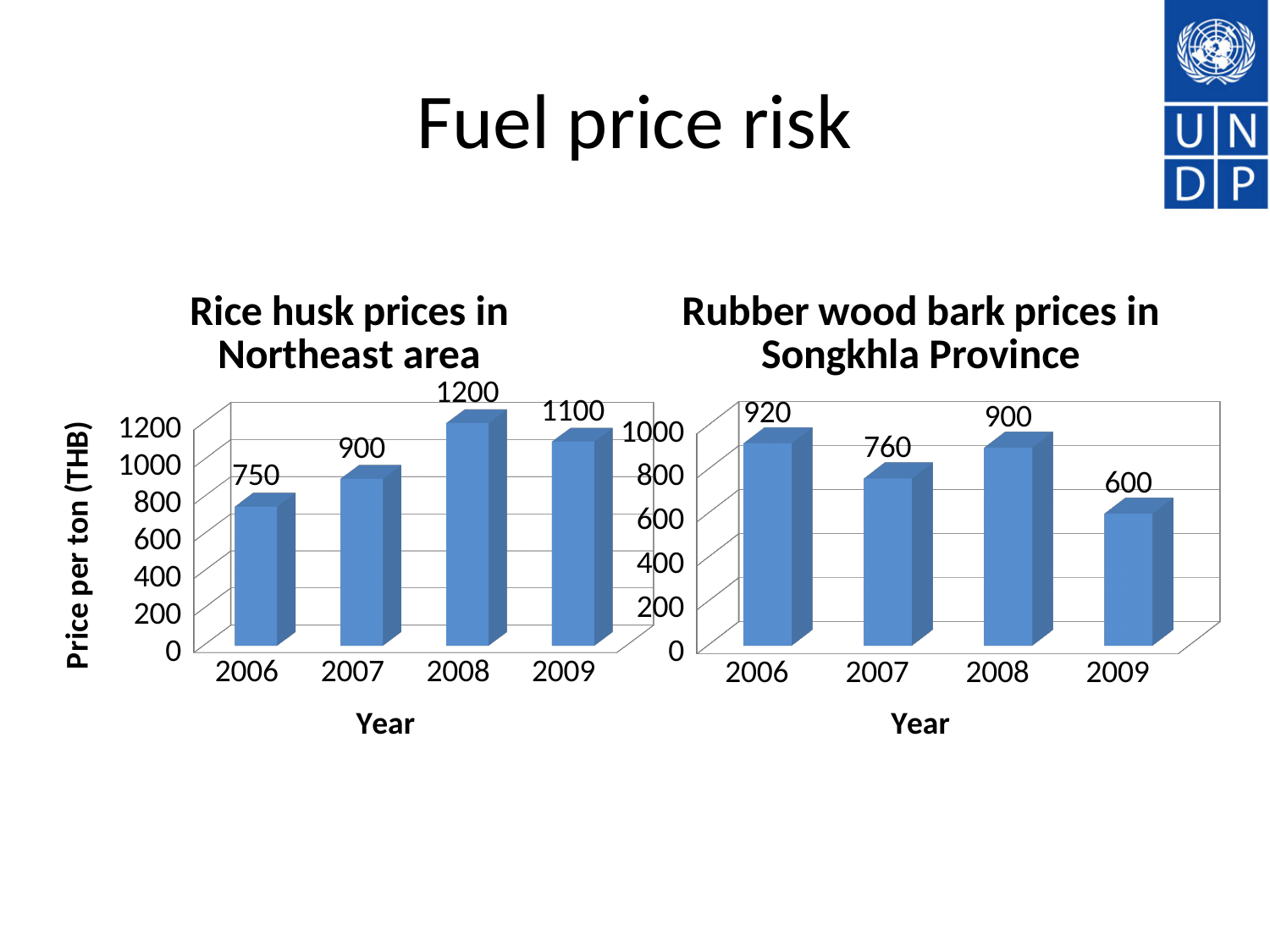
How many years are shown on the x axis of the 'Rice husk prices in Northeast area' chart? 4 In the 'Rubber wood bark prices in Songkhla Province' chart, is the value for 2009 greater or less than 800? less In the 'Rice husk prices in Northeast area' chart, which year has the lowest price? 2006 What kind of chart is the 'Rubber wood bark prices in Songkhla Province' chart? bar chart In the 'Rubber wood bark prices in Songkhla Province' chart, what is the price per ton in 2007? 760 In the 'Rice husk prices in Northeast area' chart, what is the price per ton in 2008? 1200 What is the y-axis label of the 'Rice husk prices in Northeast area' chart? Price per ton (THB) In the 'Rubber wood bark prices in Songkhla Province' chart, which year has the highest price? 2006 In the 'Rice husk prices in Northeast area' chart, which is larger, the 2007 price or the 2009 price? 2009 In the 'Rice husk prices in Northeast area' chart, what is the difference between the 2008 and 2006 prices? 450 In the 'Rubber wood bark prices in Songkhla Province' chart, do prices rise or fall from 2008 to 2009? fall In the 'Rubber wood bark prices in Songkhla Province' chart, what is the difference between the 2006 and 2009 prices? 320